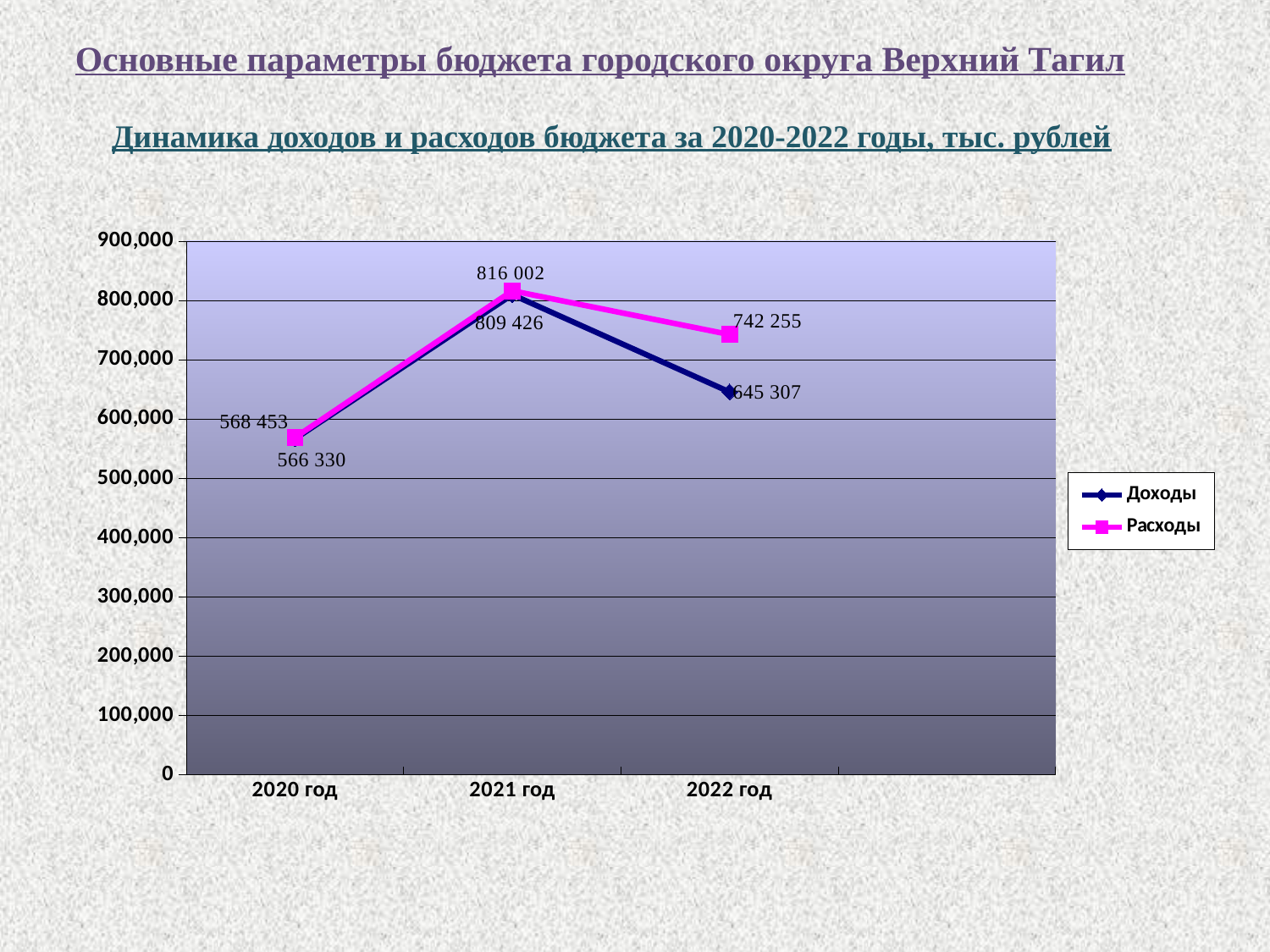
What is the difference between Расходы and Доходы in 2022 год? 96 948 What is the value of Расходы for 2020 год? 568 453 What is the value of Расходы for 2022 год? 742 255 How many years are plotted on the x axis? 3 How many series does the legend list? 2 In which year is Доходы lowest? 2020 год What is the value of Доходы for 2020 год? 566 330 What is the value of Доходы for 2021 год? 809 426 What kind of chart is shown? line chart In which year is Расходы highest? 2021 год Is the value of Доходы for 2022 год greater or less than 700,000? less Which is larger in 2022 год, Доходы or Расходы? Расходы